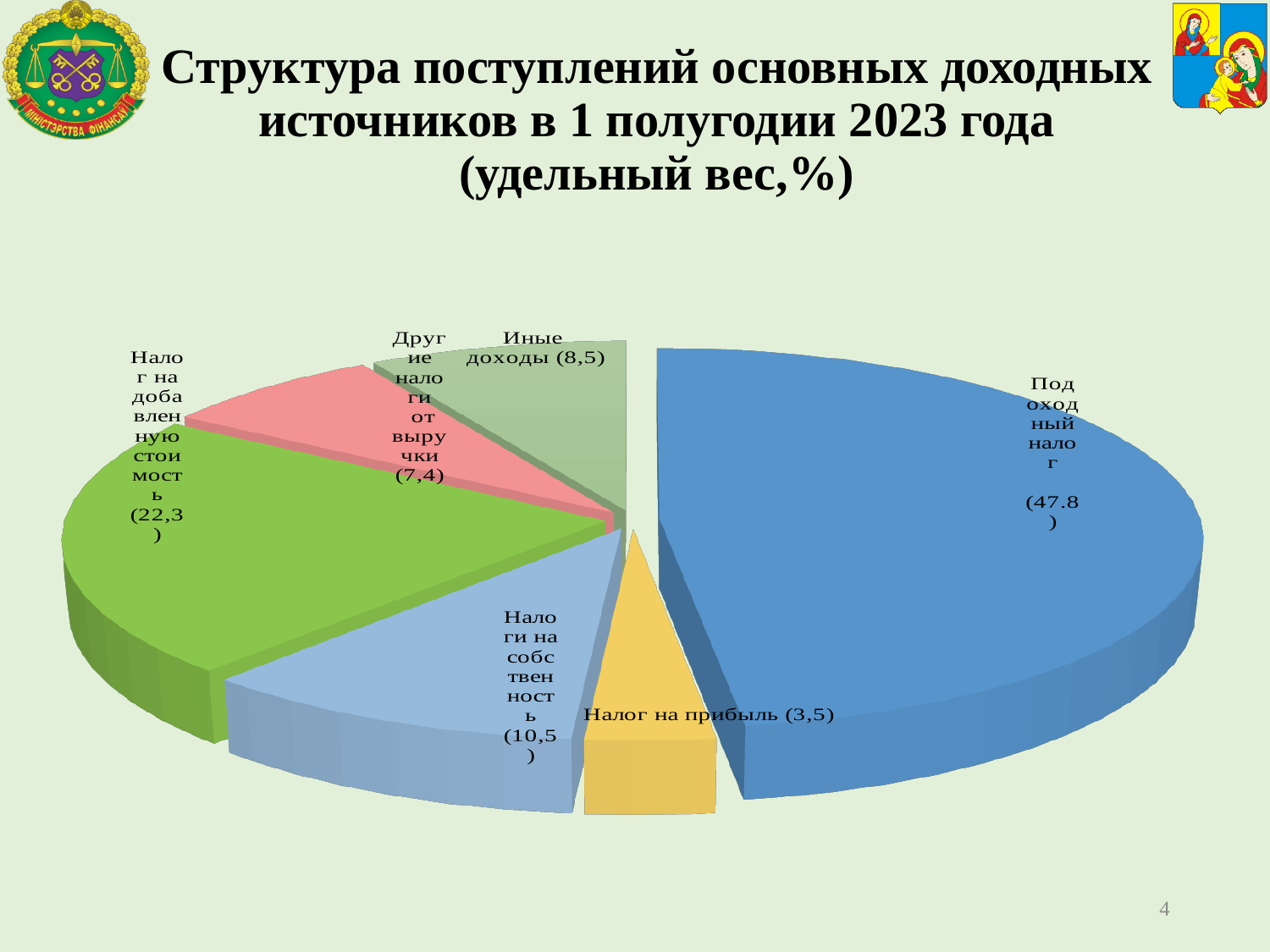
How many slices does the pie chart have? 6 What kind of chart is shown on the slide? pie chart What is the share of Налог на добавленную стоимость in the pie chart? 22,3 What is the share of Иные доходы in the pie chart? 8,5 Which category has the largest slice of the pie chart? Подоходный налог Which is larger, the share of Иные доходы or the share of Другие налоги от выручки? Иные доходы What is the share of Другие налоги от выручки in the pie chart? 7,4 What is the share of Подоходный налог in the pie chart? 47.8 What is the share of Налог на прибыль in the pie chart? 3,5 Which category has the smallest slice of the pie chart? Налог на прибыль What is the difference between the shares of Налог на добавленную стоимость and Налоги на собственность? 11,8 What is the share of Налоги на собственность in the pie chart? 10,5